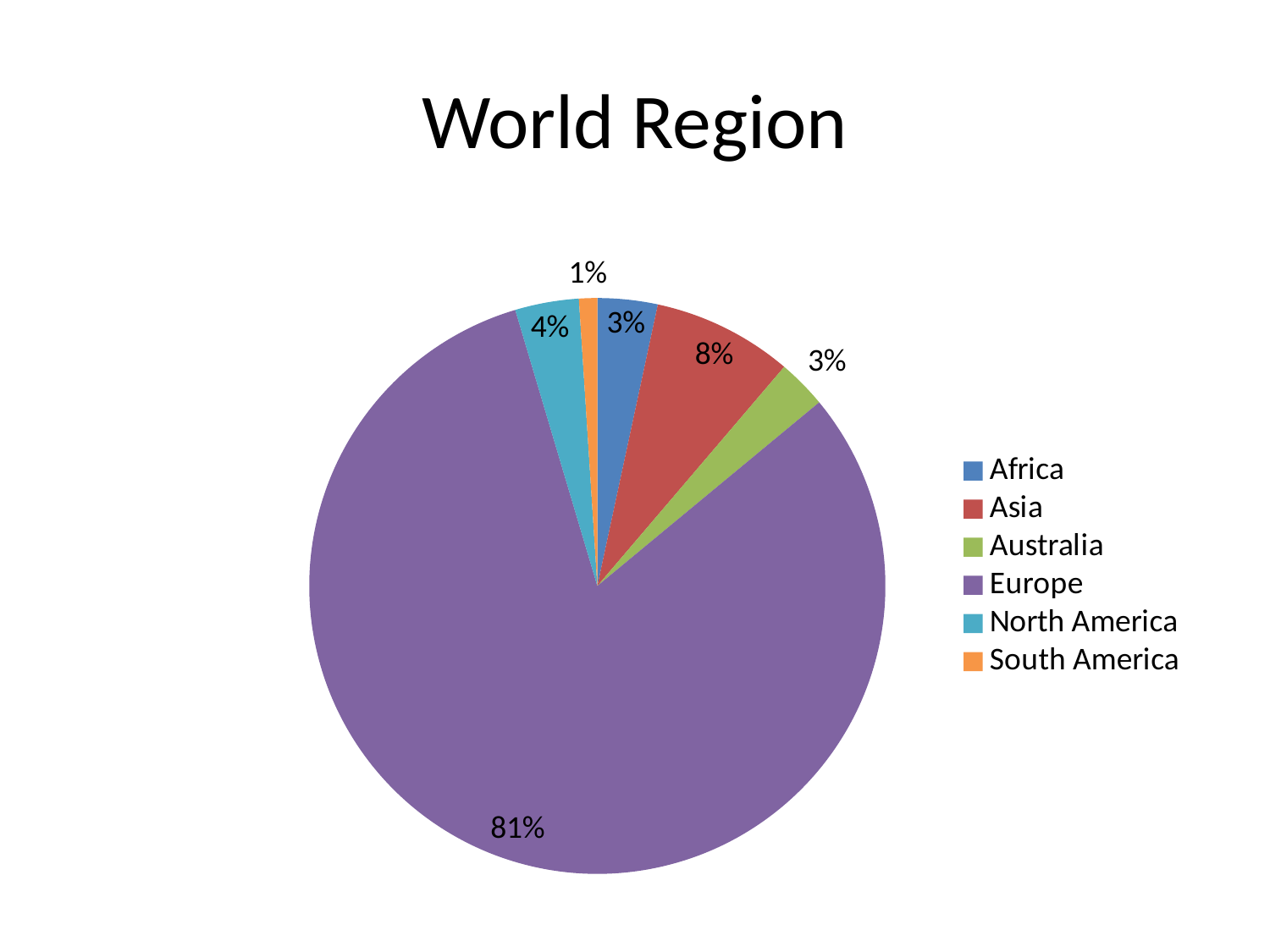
How many regions are shown in the pie chart? 6 What is the title of the chart? World Region Which region has the largest slice of the pie? Europe What share of the pie does Europe have? 81% What share of the pie does North America have? 4% What share of the pie does South America have? 1% What is the difference in percentage points between Europe's share and Asia's share? 73 Which colour represents Europe in the legend? purple Which region has the smallest slice of the pie? South America Which is larger, the share for Asia or the share for North America? Asia What type of chart is shown on the slide? pie chart